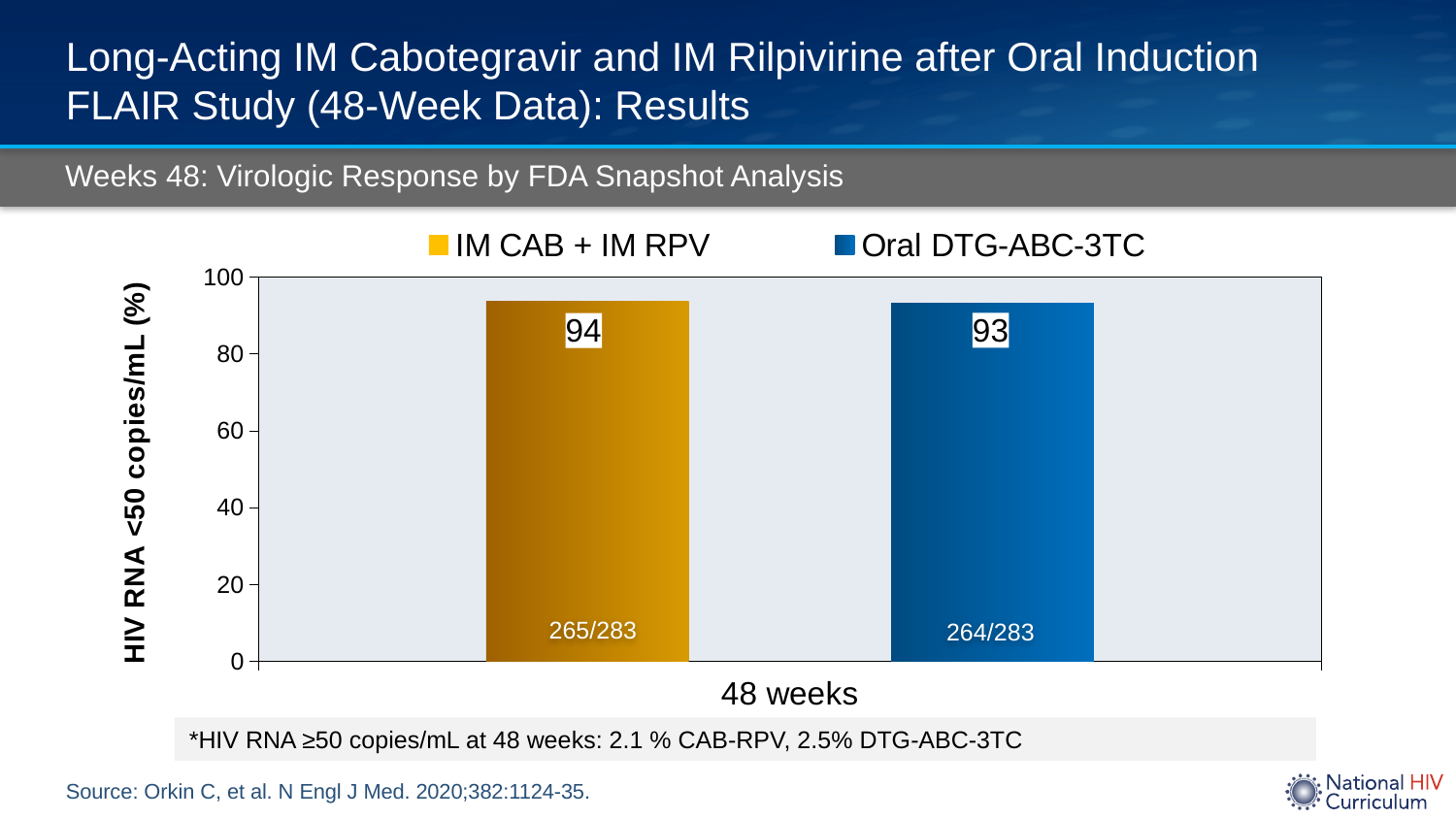
What fraction of participants is printed on the IM CAB + IM RPV bar? 265/283 What is the label on the y axis of the chart? HIV RNA <50 copies/mL (%) How many series does the legend list? 2 What is the value for Oral DTG-ABC-3TC at 48 weeks? 93 What fraction of participants is printed on the Oral DTG-ABC-3TC bar? 264/283 How many categories are shown on the x axis? 1 What is the difference between the IM CAB + IM RPV value and the Oral DTG-ABC-3TC value? 1 Is the value for Oral DTG-ABC-3TC greater or less than 80? greater What kind of chart is shown on the slide? bar chart What is the value for IM CAB + IM RPV at 48 weeks? 94 What is the category label shown on the x axis? 48 weeks